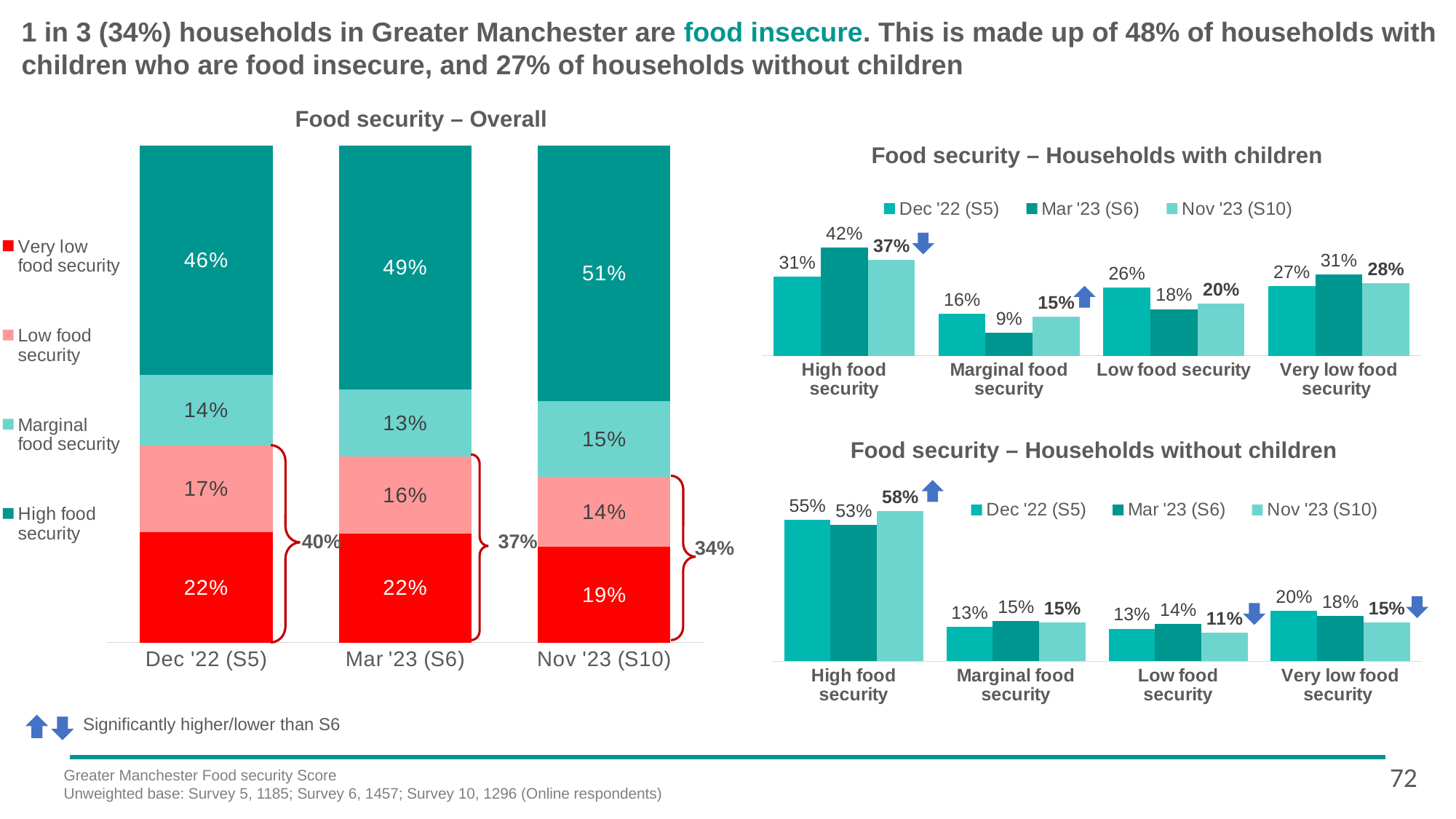
In the 'Food security – Overall' chart, how many series does the legend list? 4 In the 'Food security – Overall' chart, what is the Very low food security value for Dec '22 (S5)? 22% In the 'Food security – Households without children' chart, which is larger: Low food security for Mar '23 (S6) or Nov '23 (S10)? Mar '23 (S6) What kind of chart is 'Food security – Overall'? Stacked bar chart In the 'Food security – Households with children' chart, which survey wave has the lowest Marginal food security value? Mar '23 (S6) In the 'Food security – Households without children' chart, does the Very low food security value rise or fall from Dec '22 (S5) to Nov '23 (S10)? Fall In the 'Food security – Households without children' chart, how many categories are shown on the x axis? 4 In the 'Food security – Households without children' chart, what is the High food security value for Nov '23 (S10)? 58% In the 'Food security – Overall' chart, what is the High food security value for Nov '23 (S10)? 51% In the 'Food security – Households with children' chart, what is the High food security value for Mar '23 (S6)? 42% In the 'Food security – Overall' chart, what is the combined Low and Very low food security share shown for Mar '23 (S6)? 37% In the 'Food security – Households with children' chart, what is the difference between the Low food security values for Dec '22 (S5) and Mar '23 (S6)? 8%